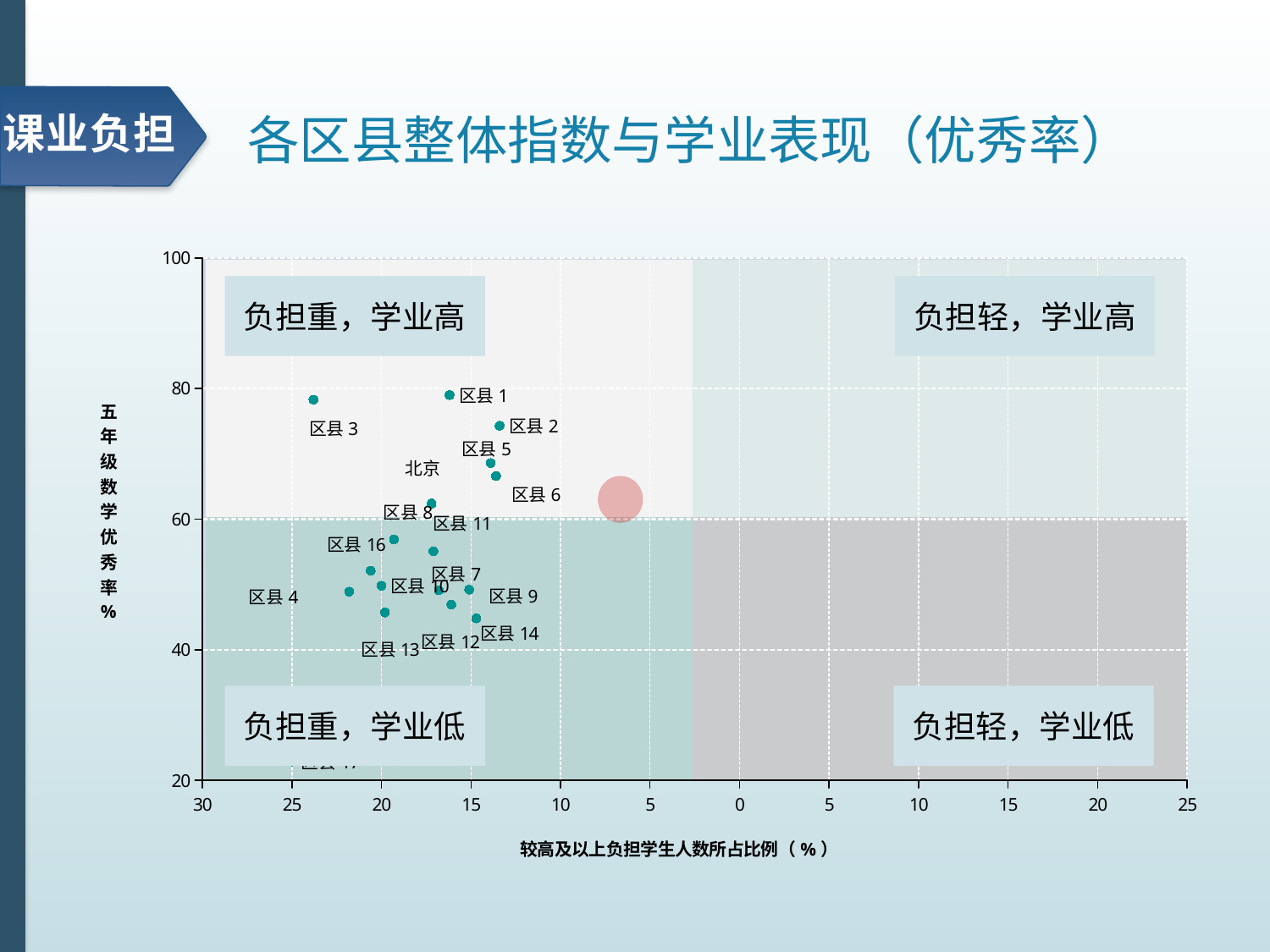
Is the value for 区县 13 on the vertical axis greater or less than 60? less Which has the higher vertical-axis value, 区县 1 or 区县 14? 区县 1 Is the value for 区县 2 on the vertical axis greater or less than 80? less Is the value for 区县 4 on the vertical axis (五年级数学优秀率) greater or less than 60? less What is the title of the chart on the slide? 各区县整体指数与学业表现（优秀率） Which has the higher vertical-axis value (五年级数学优秀率), 区县 3 or 区县 4? 区县 3 Which has the higher vertical-axis value, 区县 2 or 区县 9? 区县 2 What label is shown in the top-left quadrant of the chart? 负担重，学业高 What kind of chart is shown on the slide? scatter chart